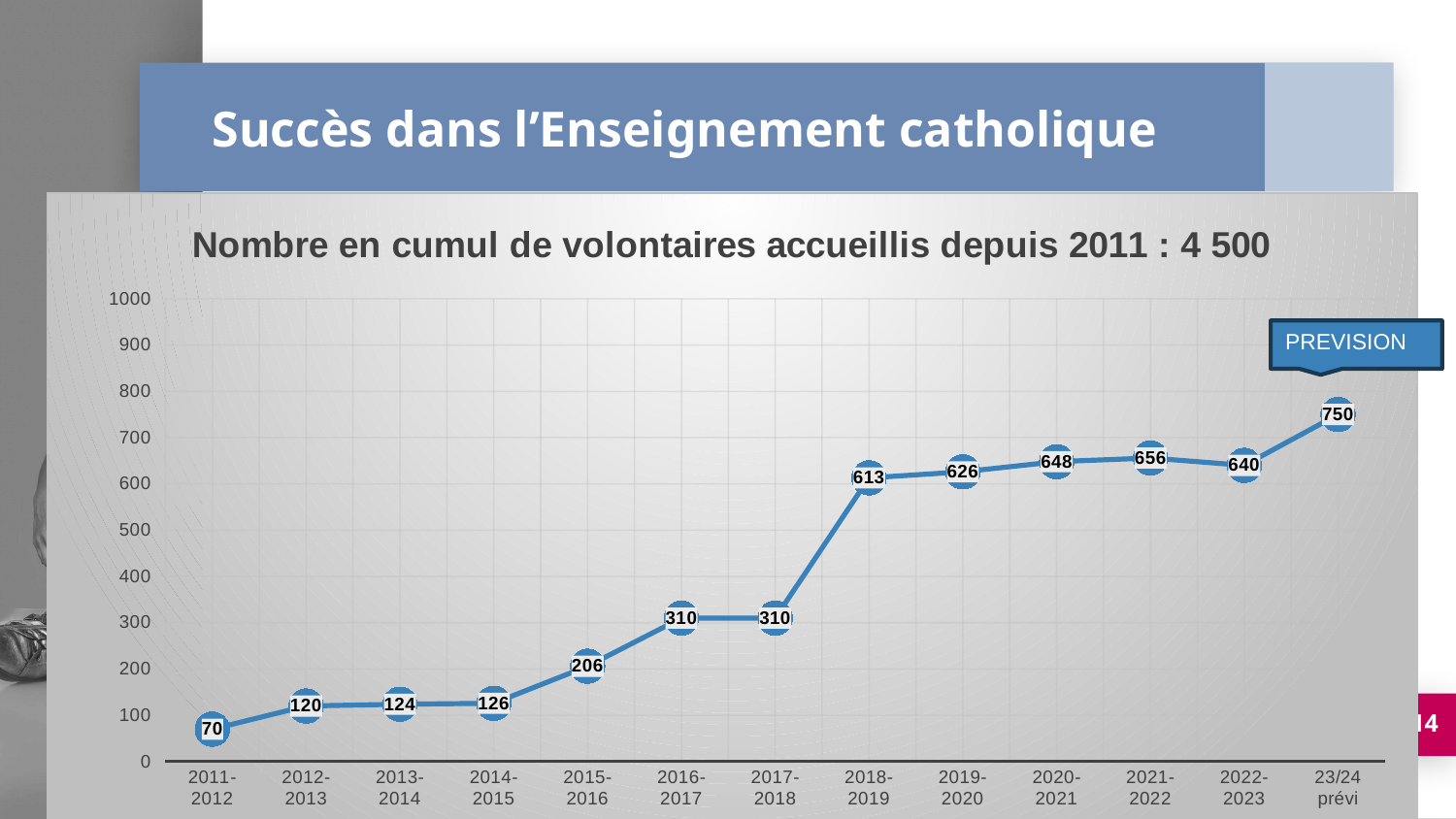
How many periods are plotted on the x axis? 13 Which is larger, the value for 2021-2022 or the value for 2022-2023? 2021-2022 What is the title of the chart? Nombre en cumul de volontaires accueillis depuis 2011 : 4 500 Do the values generally rise or fall from 2011-2012 to 2018-2019? rise What is the value for 2018-2019? 613 What type of chart is shown on the slide? line chart Which period has the lowest value? 2011-2012 What is the value for 2011-2012? 70 What is the value for 2022-2023? 640 What is the forecast value for 23/24 prévi? 750 What is the difference between the values for 2018-2019 and 2017-2018? 303 Which period has the highest value? 23/24 prévi